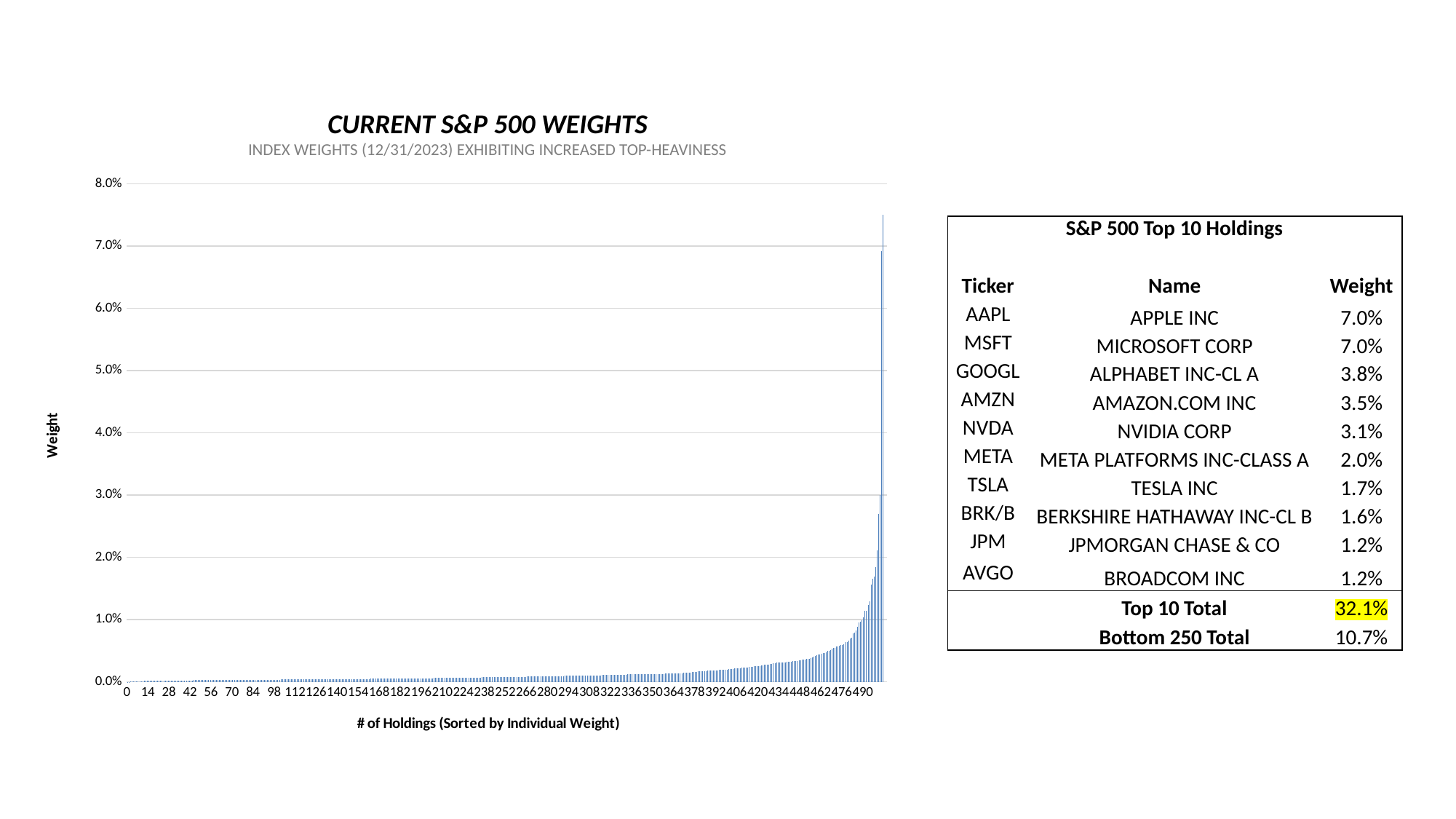
According to the table next to the chart, which is larger, the weight of AMAZON.COM INC or the weight of TESLA INC? AMAZON.COM INC Is the value for holding number 350 greater or less than 1.0%? less What is the highest value shown on the y axis of the chart? 8.0% Is the value for holding number 0 greater or less than 1.0%? less What kind of chart is shown on the slide? bar chart According to the table next to the chart, what is the Top 10 Total weight? 32.1% What is the label of the x axis of the chart? # of Holdings (Sorted by Individual Weight) Do the bar heights rise or fall moving left to right along the x axis? rise According to the table next to the chart, what is the weight of NVIDIA CORP? 3.1% What is the title of the chart? CURRENT S&P 500 WEIGHTS